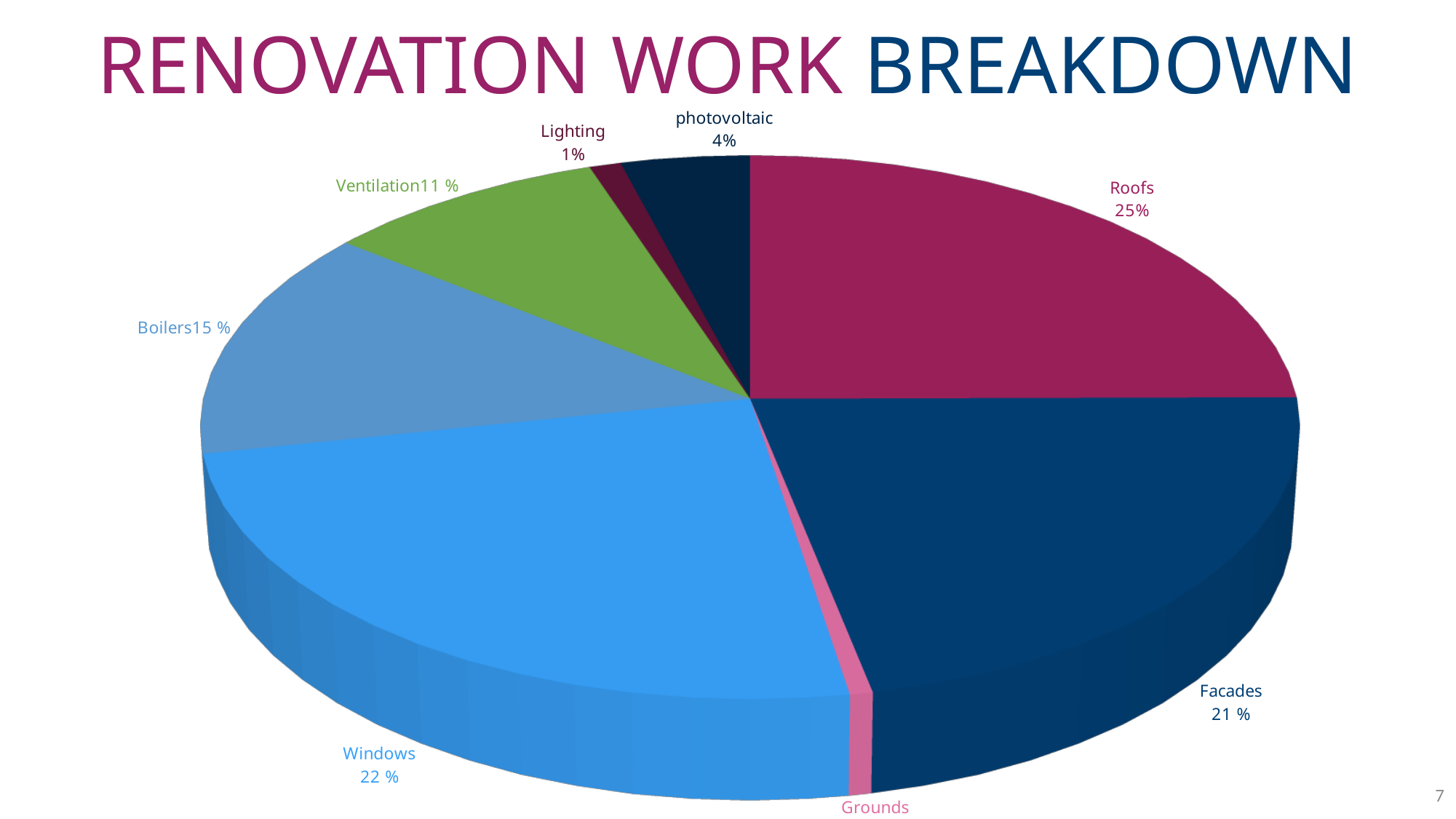
Which category has the largest slice of the pie? Roofs What percentage is shown for Boilers? 15 % What percentage is shown for Windows? 22 % What percentage is shown for Ventilation? 11 % How many slices does the pie chart have? 8 What is the title of the chart on the slide? RENOVATION WORK BREAKDOWN What percentage is shown for photovoltaic? 4% Which is larger, the share for Boilers or the share for Ventilation? Boilers What percentage is shown for Facades? 21 % What share of the pie does Roofs account for? 25% What kind of chart is shown on the slide? Pie chart By how many percentage points does Roofs exceed Facades? 4 percentage points